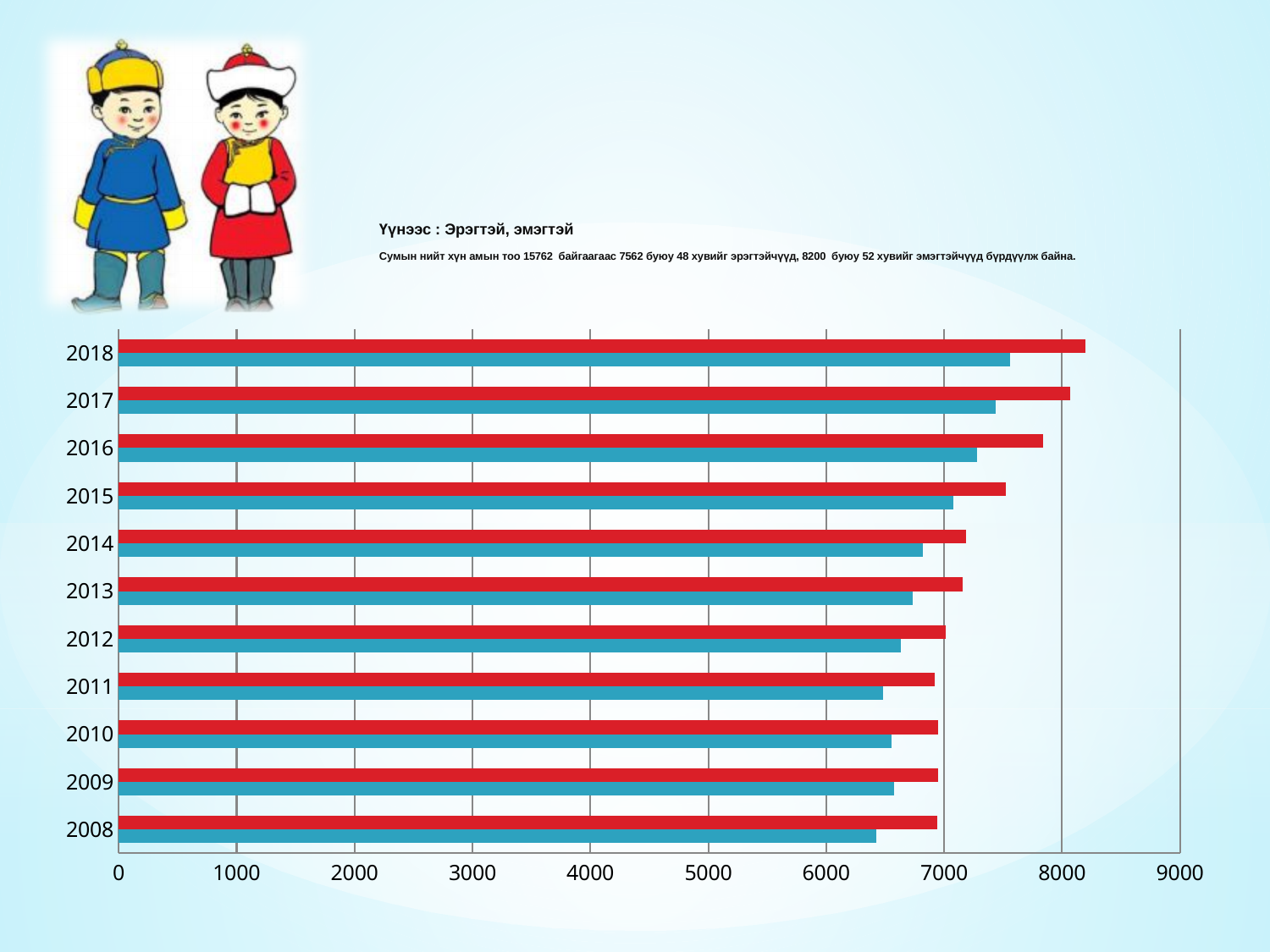
What two colours are used for the bars in the chart? red and blue Is the value of the blue bar for 2008 greater or less than 7000? less What kind of chart is shown on the slide? bar chart Which year has the longest blue bar? 2018 For 2018, which bar is longer, the red bar or the blue bar? the red bar How many years are shown on the vertical axis of the chart? 11 Do the red bar values rise or fall from 2008 to 2018? rise Is the value of the red bar for 2018 greater or less than 8000? greater Is the value of the red bar for 2016 greater or less than 8000? less Which year has the longest red bar? 2018 How many bars are plotted for each year in the chart? 2